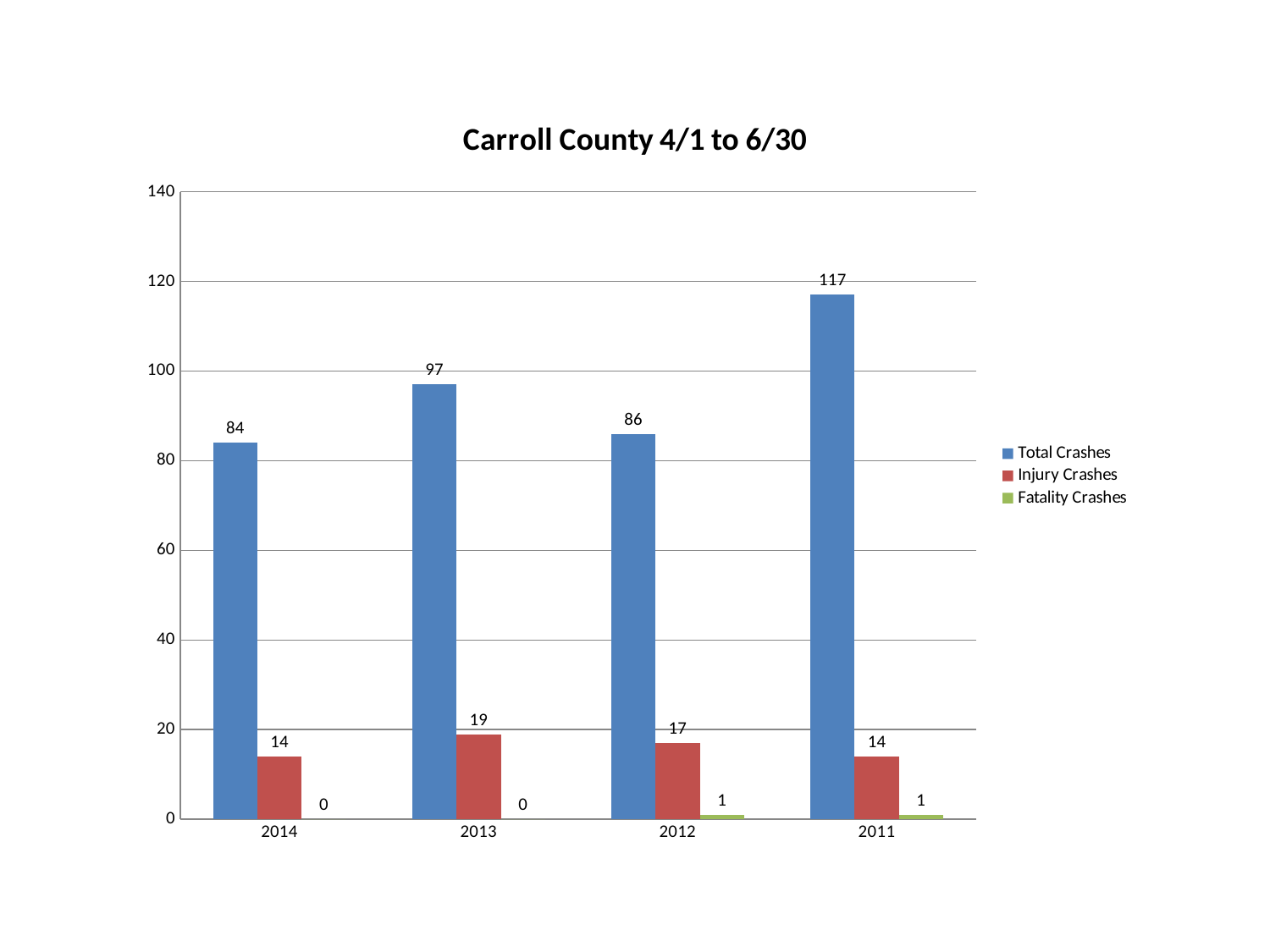
What is the difference between Total Crashes in 2011 and 2014? 33 Which is larger, Injury Crashes in 2013 or Injury Crashes in 2012? 2013 How many series does the legend list? 3 What is the value of Total Crashes for 2011? 117 What is the value of Fatality Crashes for 2014? 0 What kind of chart is shown? bar chart Which year has the lowest Total Crashes? 2014 How many years are shown on the x axis? 4 Is the value of Total Crashes for 2013 greater or less than 100? less Which year has the highest Total Crashes? 2011 What is the title of the chart? Carroll County 4/1 to 6/30 What is the value of Injury Crashes for 2013? 19